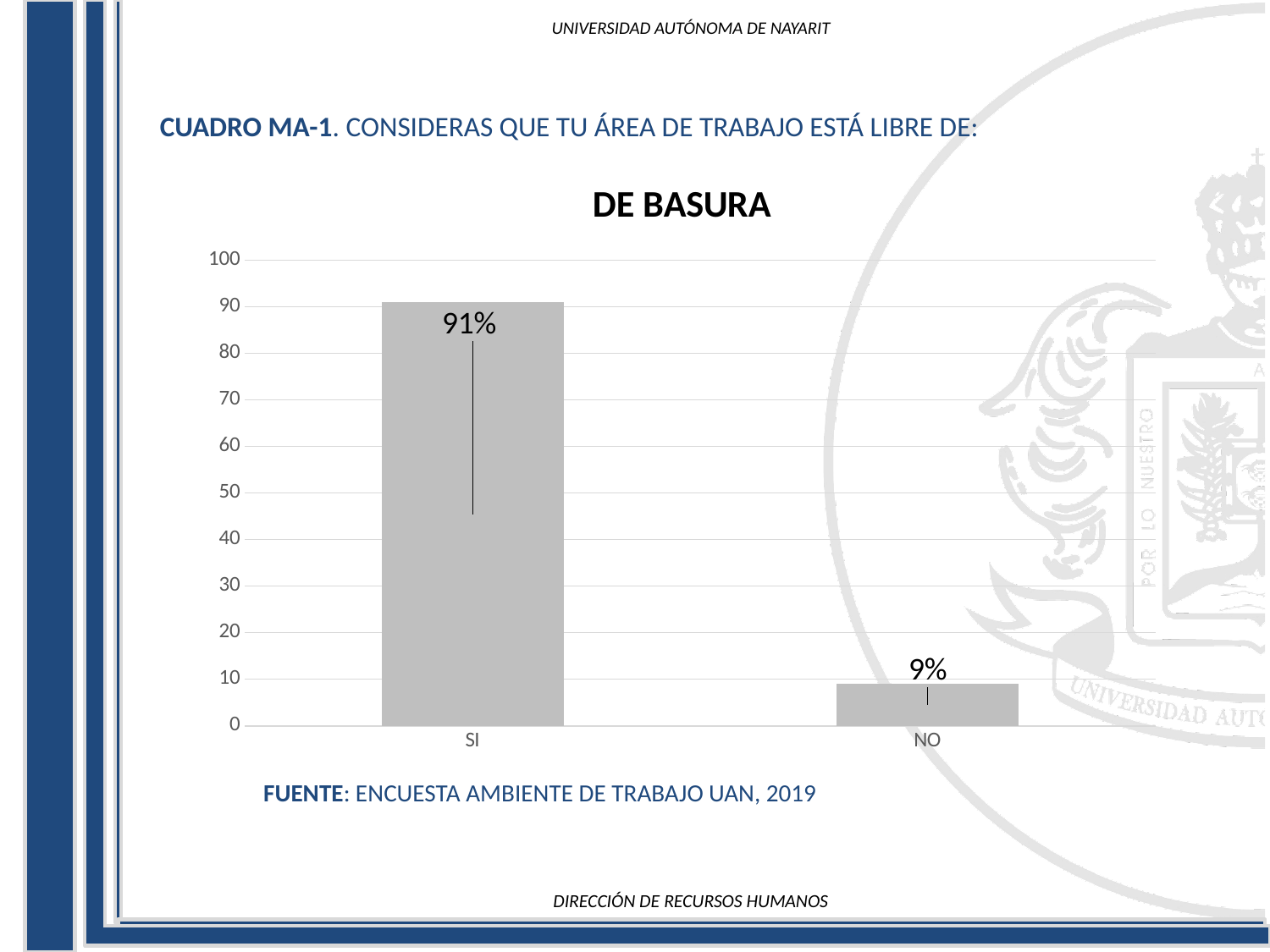
Is the value for SI greater or less than 50? greater What is the difference between the values for SI and NO? 82% Which category has the lowest value? NO Which is larger, the value for SI or the value for NO? SI What is the highest value shown on the y axis? 100 How many categories are shown on the x axis? 2 Which category has the highest value? SI What kind of chart is shown? bar chart What is the value for NO? 9% What is the title of the chart? DE BASURA What is the value for SI? 91% Is the value for NO greater or less than 20? less